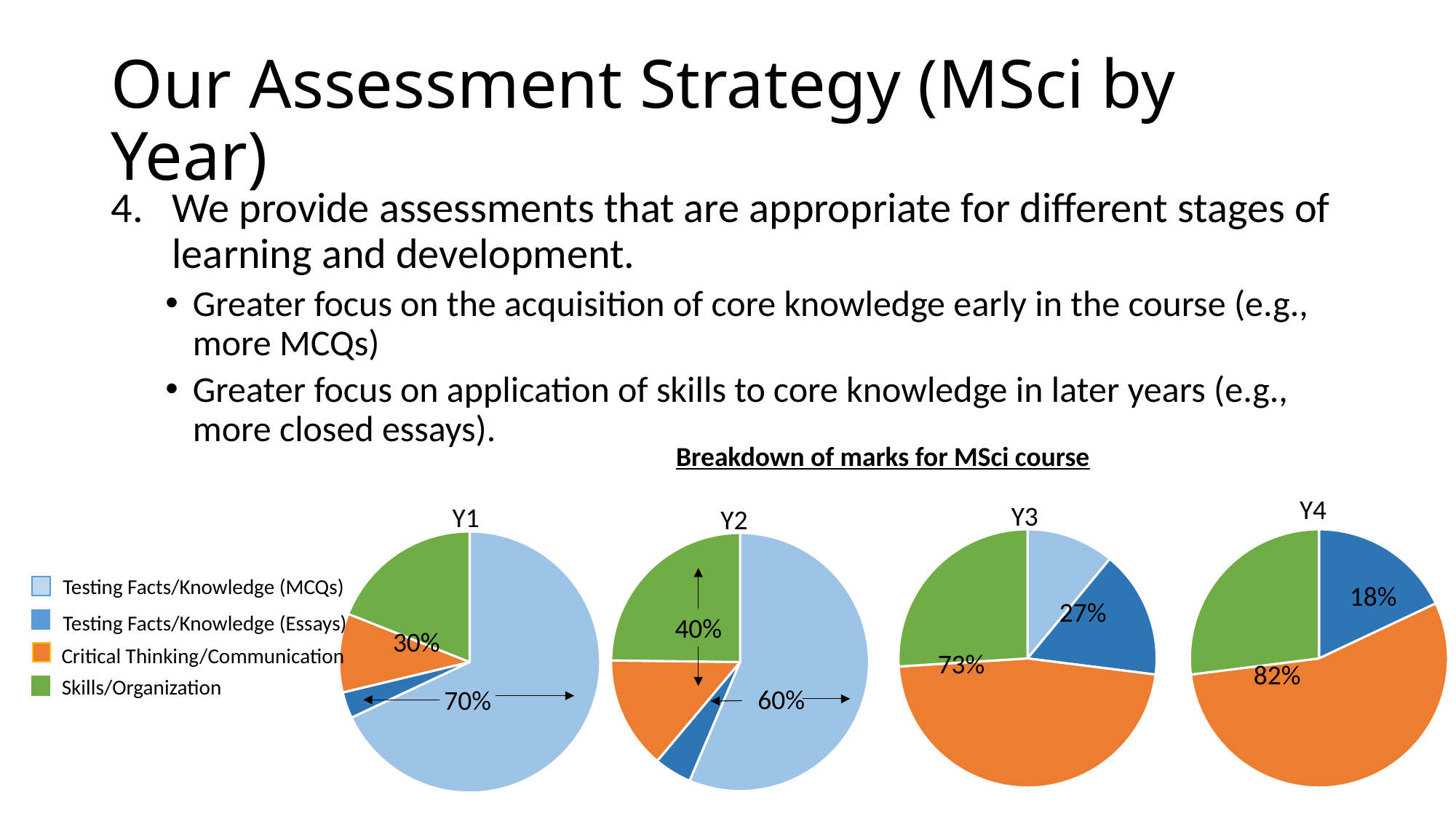
In the Y4 pie chart, which legend category has the largest slice? Critical Thinking/Communication Which legend category has no slice in the Y4 pie chart? Testing Facts/Knowledge (MCQs) In the Y4 pie chart, what percentage is labelled on the orange and green portion? 82% What kind of charts are shown under the heading 'Breakdown of marks for MSci course'? Pie charts In the Y1 pie chart, which legend category has the largest slice? Testing Facts/Knowledge (MCQs) How many categories does the legend for the pie charts list? 4 In the Y4 pie chart, what percentage is labelled on the dark-blue slice? 18% In the Y3 pie chart, what percentage is labelled near the blue slices? 27% In the Y2 pie chart, what percentage label is shown with the vertical arrow over the green and orange portion? 40% How many pie charts are shown on the slide? 4 In the Y1 pie chart, what percentage is labelled on the large light-blue slice? 70% In the Y1 pie chart, which legend category has the smallest slice? Testing Facts/Knowledge (Essays)